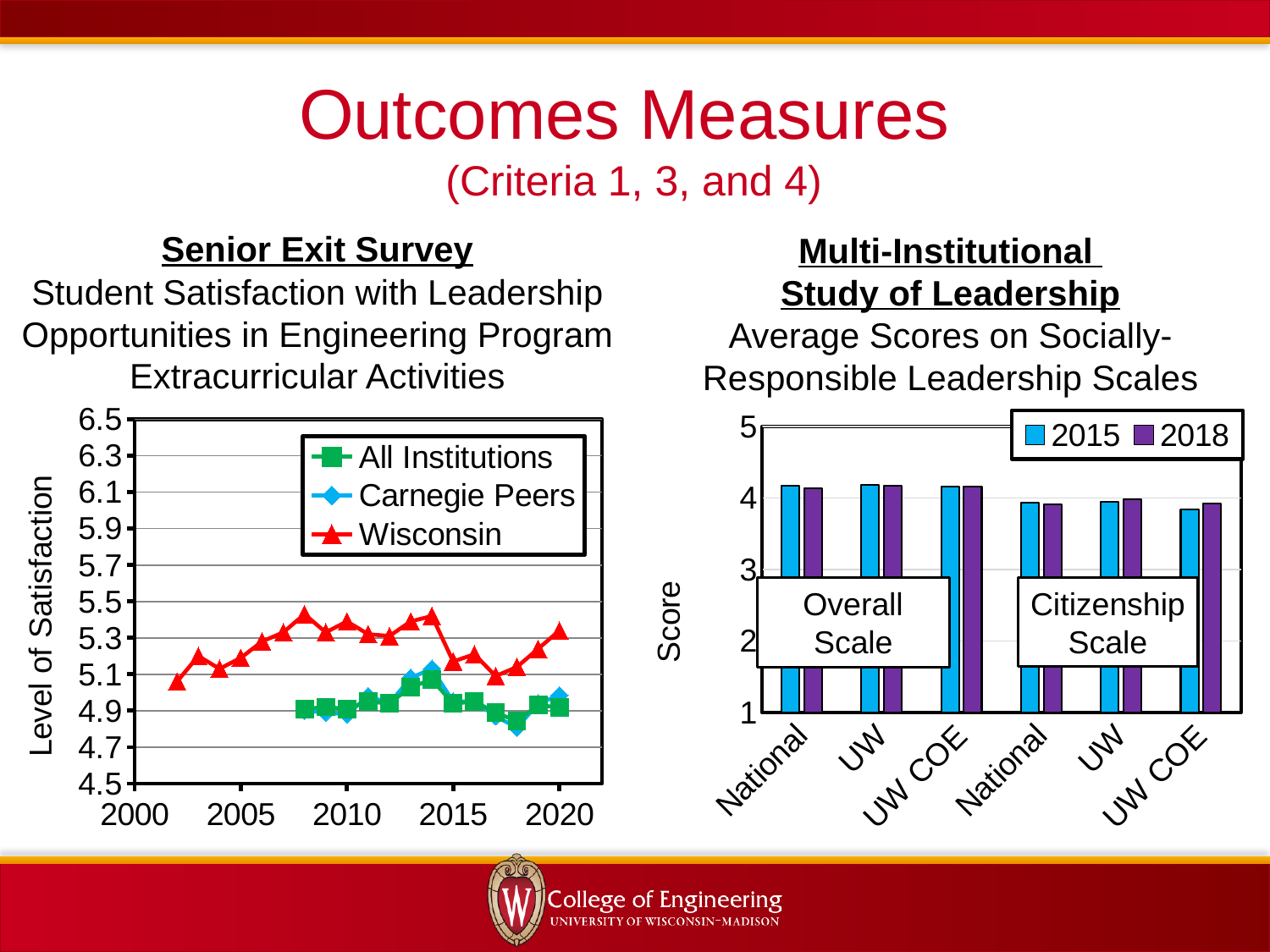
In the Senior Exit Survey chart, is the Carnegie Peers value for 2018 greater or less than 4.9? less In the Senior Exit Survey chart, which series has the highest level of satisfaction across the years shown? Wisconsin What is the y-axis label of the Senior Exit Survey chart? Level of Satisfaction What kind of chart is the Senior Exit Survey chart on the left? line chart How many series does the legend of the Senior Exit Survey chart list? 3 In the Multi-Institutional Study of Leadership chart, which is larger: the 2015 UW score on the Overall Scale or the 2015 UW score on the Citizenship Scale? Overall Scale In the Senior Exit Survey chart, is the Wisconsin value for 2020 greater or less than 5.1? greater In the Senior Exit Survey chart, is the Wisconsin value for 2014 greater or less than 5.1? greater How many series does the legend of the Multi-Institutional Study of Leadership chart list? 2 What kind of chart is the Multi-Institutional Study of Leadership chart on the right? bar chart In the Multi-Institutional Study of Leadership chart, how many bars are plotted in total? 12